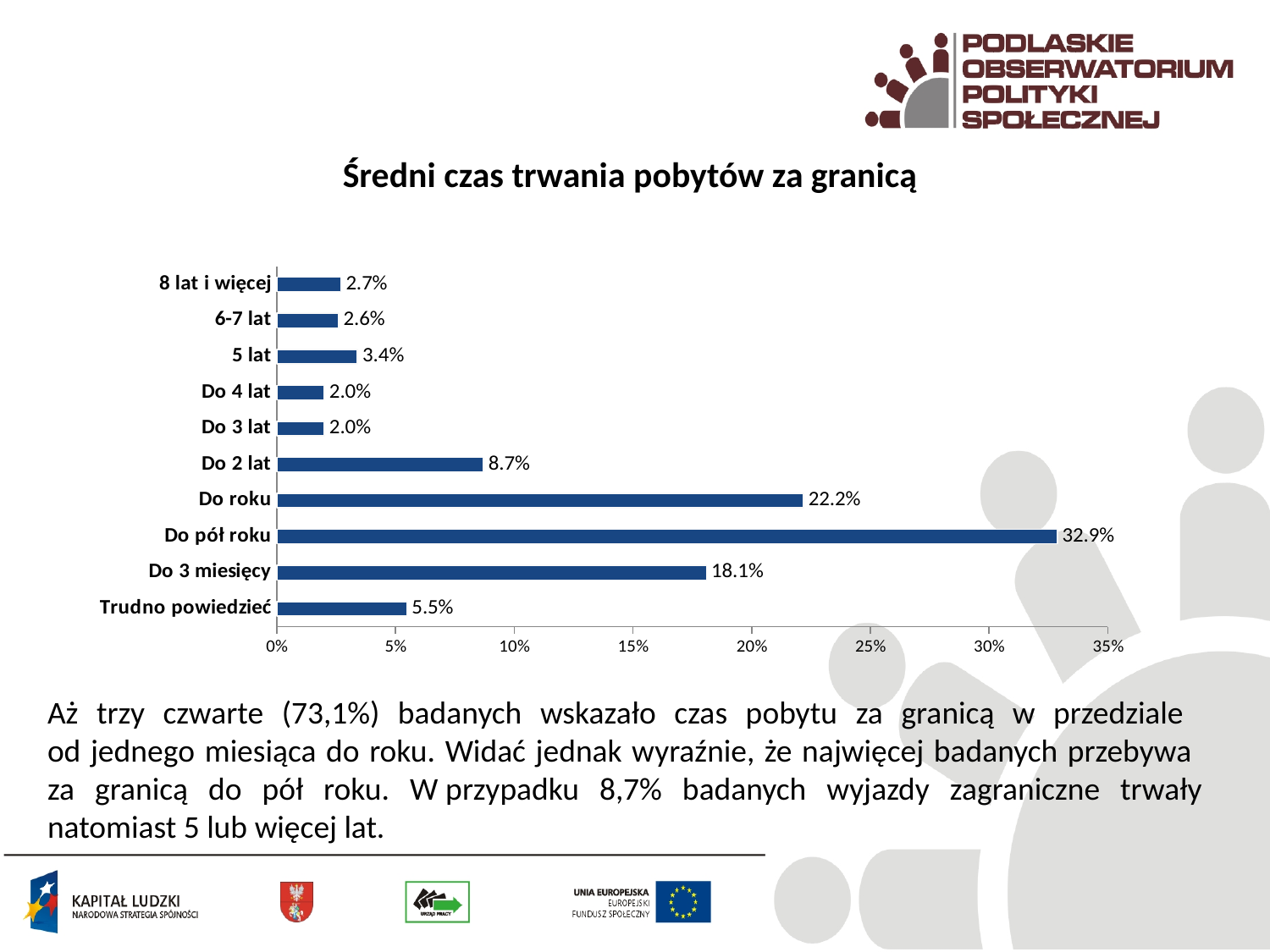
Is the value for "Do roku" greater or less than 20%? greater What is the title of the chart? Średni czas trwania pobytów za granicą What is the value for "Do pół roku"? 32.9% What is the value for "Do 3 miesięcy"? 18.1% What is the value for "5 lat"? 3.4% What is the difference between the values for "Do pół roku" and "Do roku"? 10.7% Which category has the highest value? Do pół roku What is the value for "Trudno powiedzieć"? 5.5% What is the difference between the values for "Do 3 miesięcy" and "Do 2 lat"? 9.4% What kind of chart is shown on the slide? bar chart Which is larger, the value for "Do 2 lat" or the value for "Trudno powiedzieć"? Do 2 lat How many categories are shown in the chart? 10